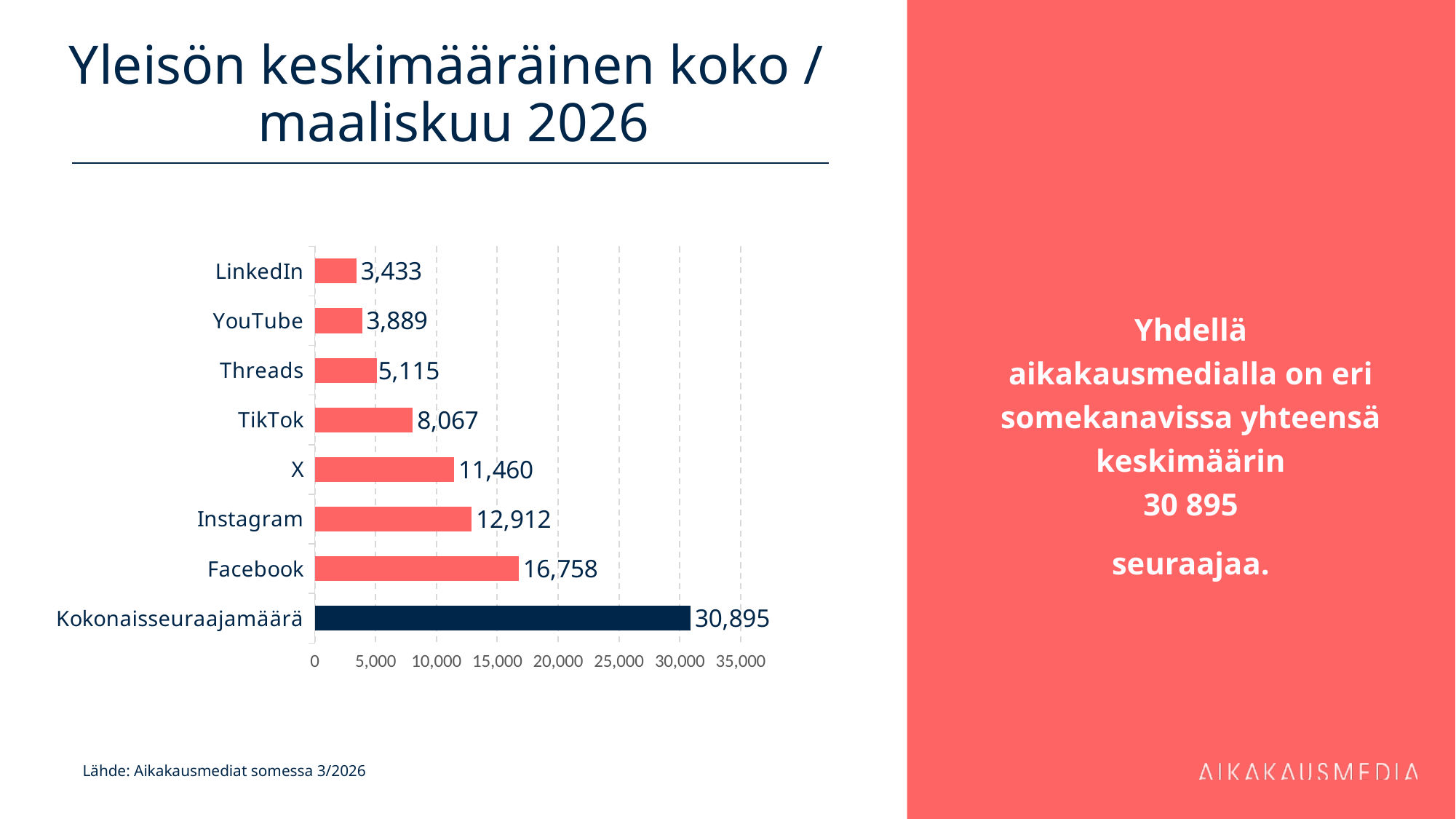
How many categories are shown in the chart? 8 Which category has the highest value? Kokonaisseuraajamäärä Which category has the lowest value? LinkedIn What is the value for Kokonaisseuraajamäärä? 30,895 What is the value for Facebook? 16,758 What is the title of the chart on the slide? Yleisön keskimääräinen koko / maaliskuu 2026 Which is larger, the value for YouTube or the value for Threads? Threads What is the value for Threads? 5,115 What is the difference between the values for Facebook and Instagram? 3,846 What is the difference between the values for X and TikTok? 3,393 What kind of chart is shown on the slide? Bar chart What is the value for TikTok? 8,067